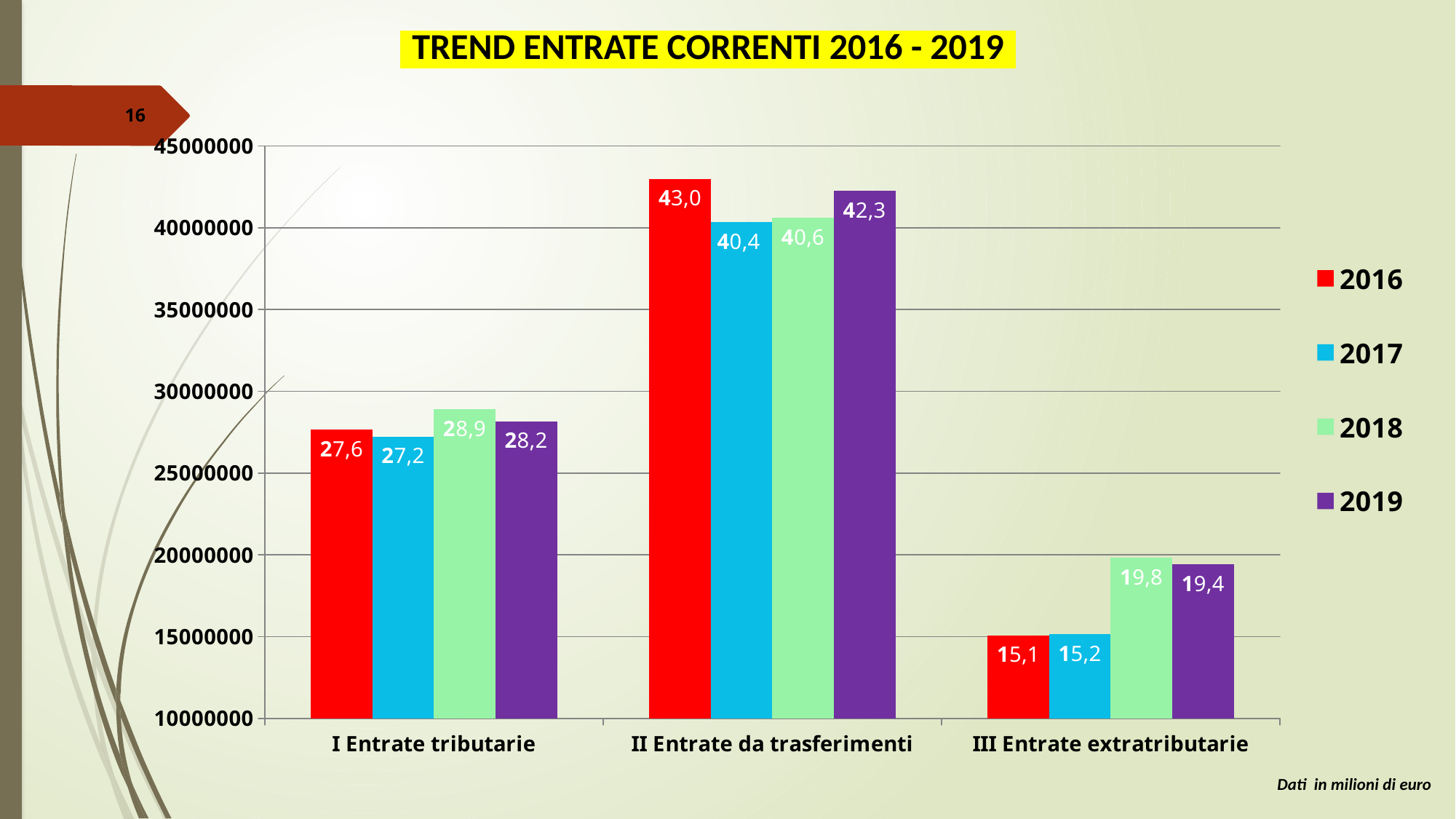
What is the title of the chart? TREND ENTRATE CORRENTI 2016 - 2019 How many series does the legend list? 4 Which year has the highest value in the 'I Entrate tributarie' category? 2018 How many categories are shown on the x axis? 3 What is the value for 2016 in the 'II Entrate da trasferimenti' category? 43,0 What kind of chart is shown on the slide? bar chart Which year has the lowest value in the 'II Entrate da trasferimenti' category? 2017 What is the value for 2017 in the 'I Entrate tributarie' category? 27,2 In the 'III Entrate extratributarie' category, which is larger: the 2018 value or the 2019 value? 2018 Is the 2019 value for 'I Entrate tributarie' greater or less than 30000000? less What is the value for 2018 in the 'III Entrate extratributarie' category? 19,8 What is the difference between the 2016 and 2019 values in the 'II Entrate da trasferimenti' category? 0,7